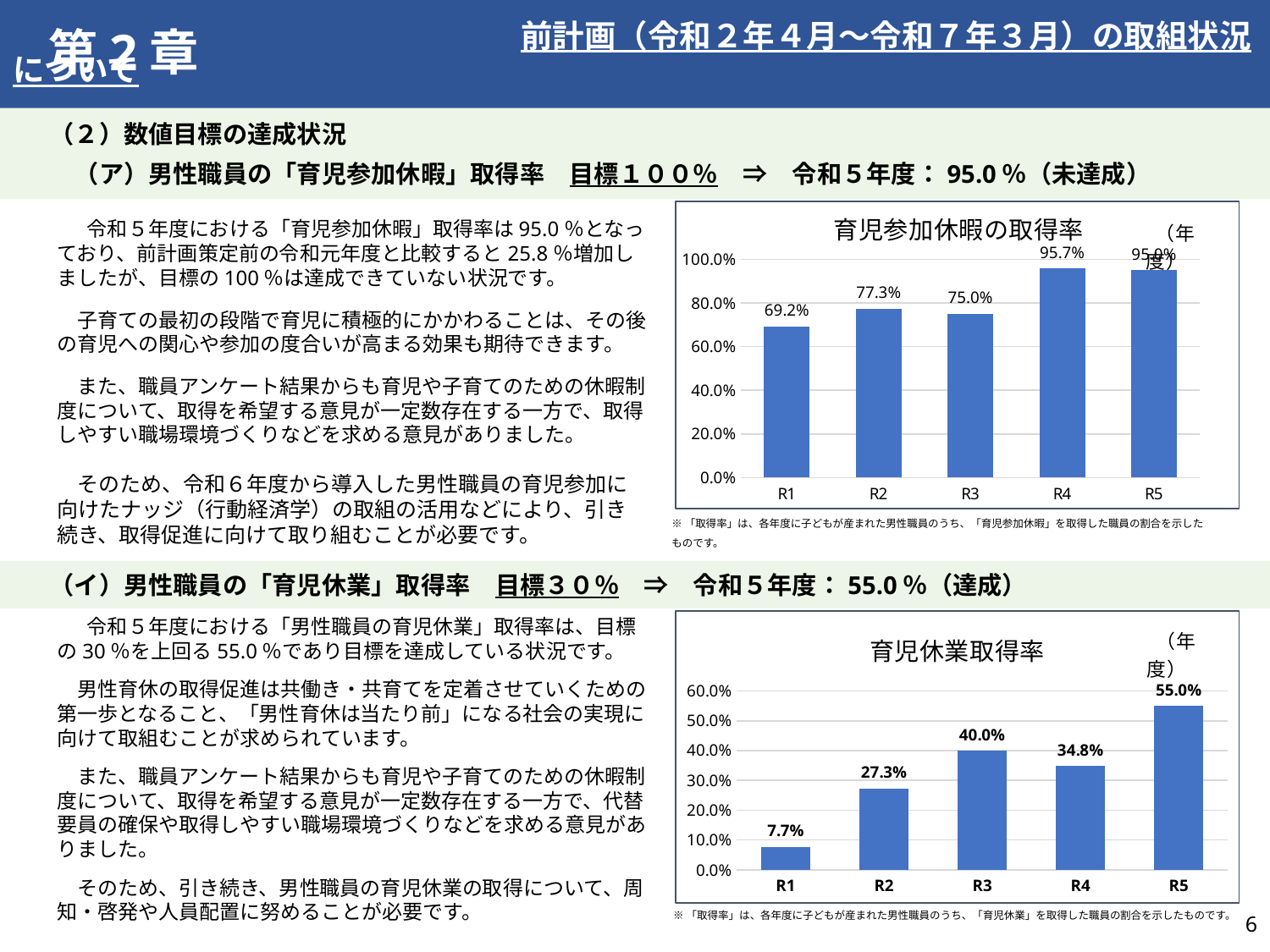
In the top chart titled 育児参加休暇の取得率, how many years are plotted? 5 In the top chart titled 育児参加休暇の取得率, what is the difference between the values for R4 and R1? 26.5% What kind of chart is the bottom chart titled 育児休業取得率? bar chart In the top chart titled 育児参加休暇の取得率, what is the value for R2? 77.3% In the bottom chart titled 育児休業取得率, what is the difference between the values for R5 and R1? 47.3% In the bottom chart titled 育児休業取得率, which year has the lowest value? R1 In the top chart titled 育児参加休暇の取得率, which year has the highest value? R4 In the top chart titled 育児参加休暇の取得率, is the value for R3 greater or less than 80.0%? less In the bottom chart titled 育児休業取得率, which is larger, the value for R3 or the value for R4? R3 In the bottom chart titled 育児休業取得率, what is the value for R3? 40.0% In the bottom chart titled 育児休業取得率, is the value for R2 greater or less than 30.0%? less In the top chart titled 育児参加休暇の取得率, which year has the lowest value? R1